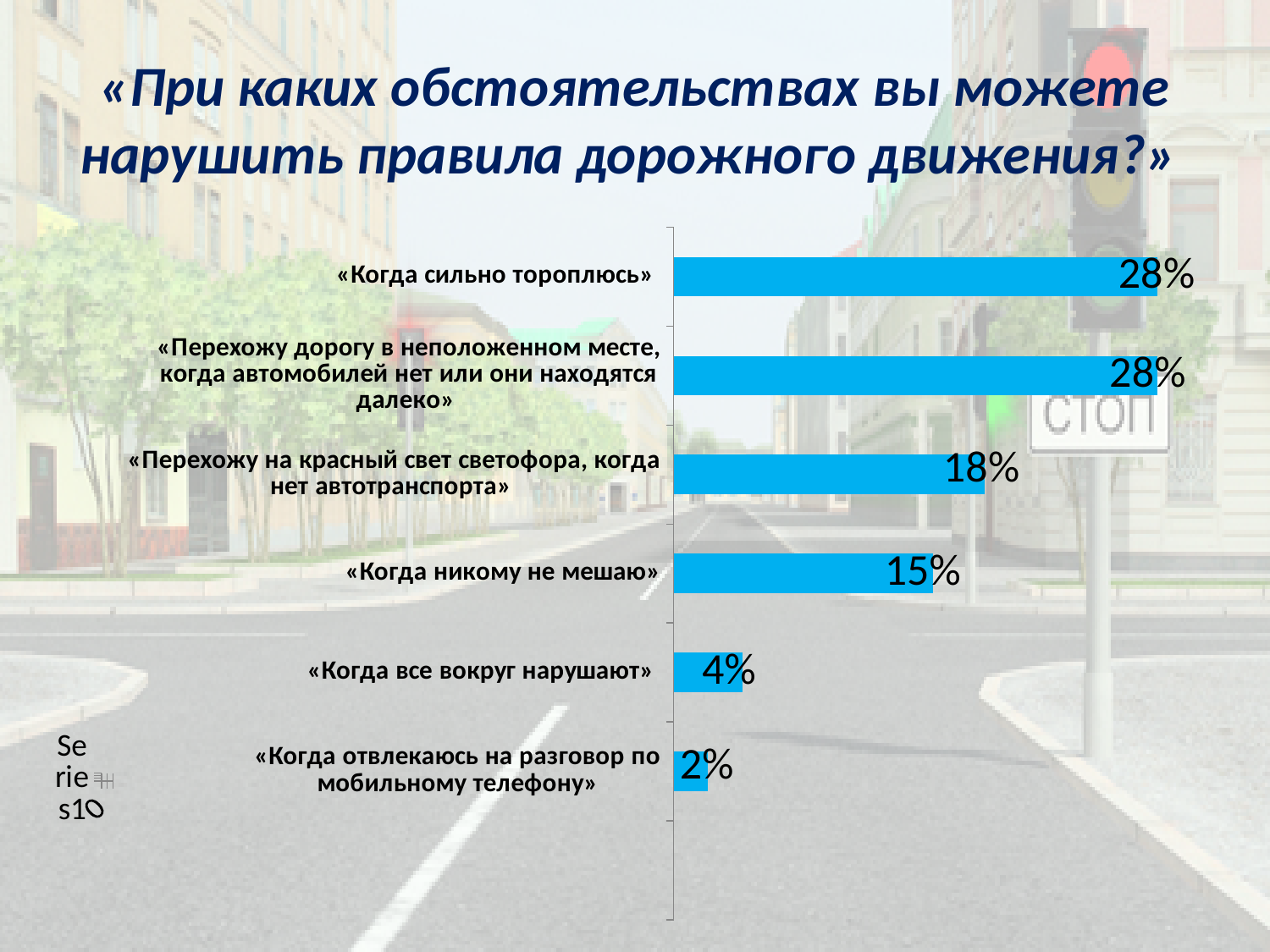
How many categories are shown in the chart? 6 What is the value for «Когда отвлекаюсь на разговор по мобильному телефону»? 2% What is the value for «Когда все вокруг нарушают»? 4% What is the value for «Когда сильно тороплюсь»? 28% What is the difference between the values for «Перехожу на красный свет светофора, когда нет автотранспорта» and «Когда никому не мешаю»? 3% What is the difference between the values for «Когда сильно тороплюсь» and «Когда все вокруг нарушают»? 24% Which is larger: the value for «Когда никому не мешаю» or the value for «Когда все вокруг нарушают»? «Когда никому не мешаю» Which category has the lowest value? «Когда отвлекаюсь на разговор по мобильному телефону» What is the value for «Перехожу на красный свет светофора, когда нет автотранспорта»? 18% What type of chart is shown on the slide? bar chart What question is given as the title of the slide above the chart? «При каких обстоятельствах вы можете нарушить правила дорожного движения?» What is the value for «Когда никому не мешаю»? 15%